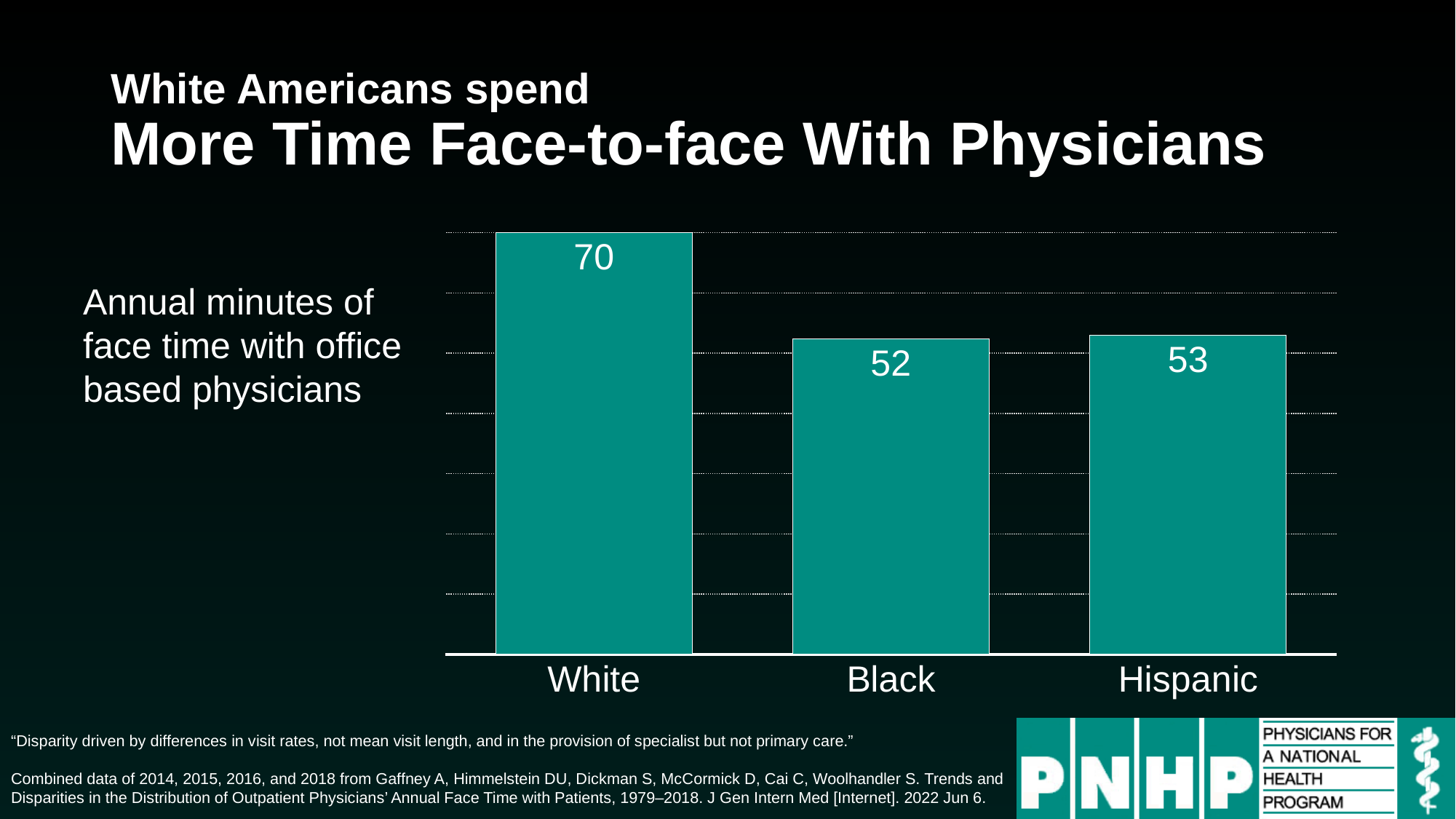
What is the value for Black? 52 How many categories are shown in the chart? 3 Which category has the highest value? White What is the difference between the values for White and Black? 18 What is the value for White? 70 What kind of chart is shown on the slide? bar chart What colour are the bars in the chart? teal What does the chart measure, according to the text to its left? Annual minutes of face time with office based physicians Which is larger, the value for White or the value for Hispanic? White What is the difference between the values for White and Hispanic? 17 Which category has the lowest value? Black What is the value for Hispanic? 53